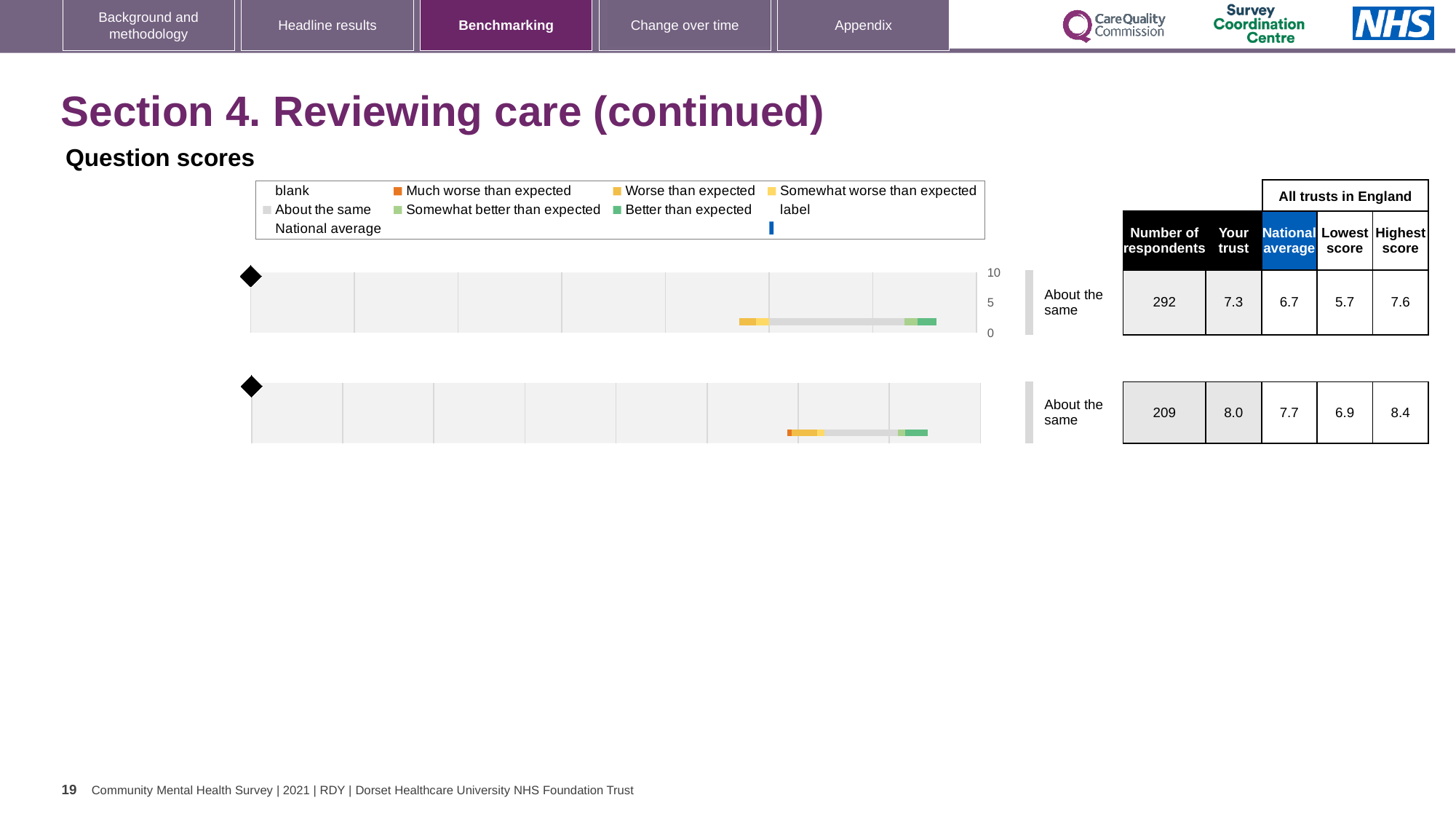
What benchmark category is shown next to the top chart? About the same In the top chart's row, what is the difference between the highest score (7.6) and the lowest score (5.7)? 1.9 In the top chart's row, which is larger: the 'Your trust' score or the national average? Your trust In the bottom chart's row, what is the 'Your trust' score? 8.0 In the top chart's row, what is the number of respondents? 292 What kind of chart is used to show the question scores on this slide? Bar chart In the top chart's row, what is the 'Your trust' score? 7.3 In the top chart's row, what is the national average score? 6.7 In the bottom chart's row, what is the difference between the 'Your trust' score and the national average? 0.3 In the bottom chart's row, what is the number of respondents? 209 In the bottom chart's row, what is the highest score among all trusts in England? 8.4 How many question score charts are shown on the slide? 2